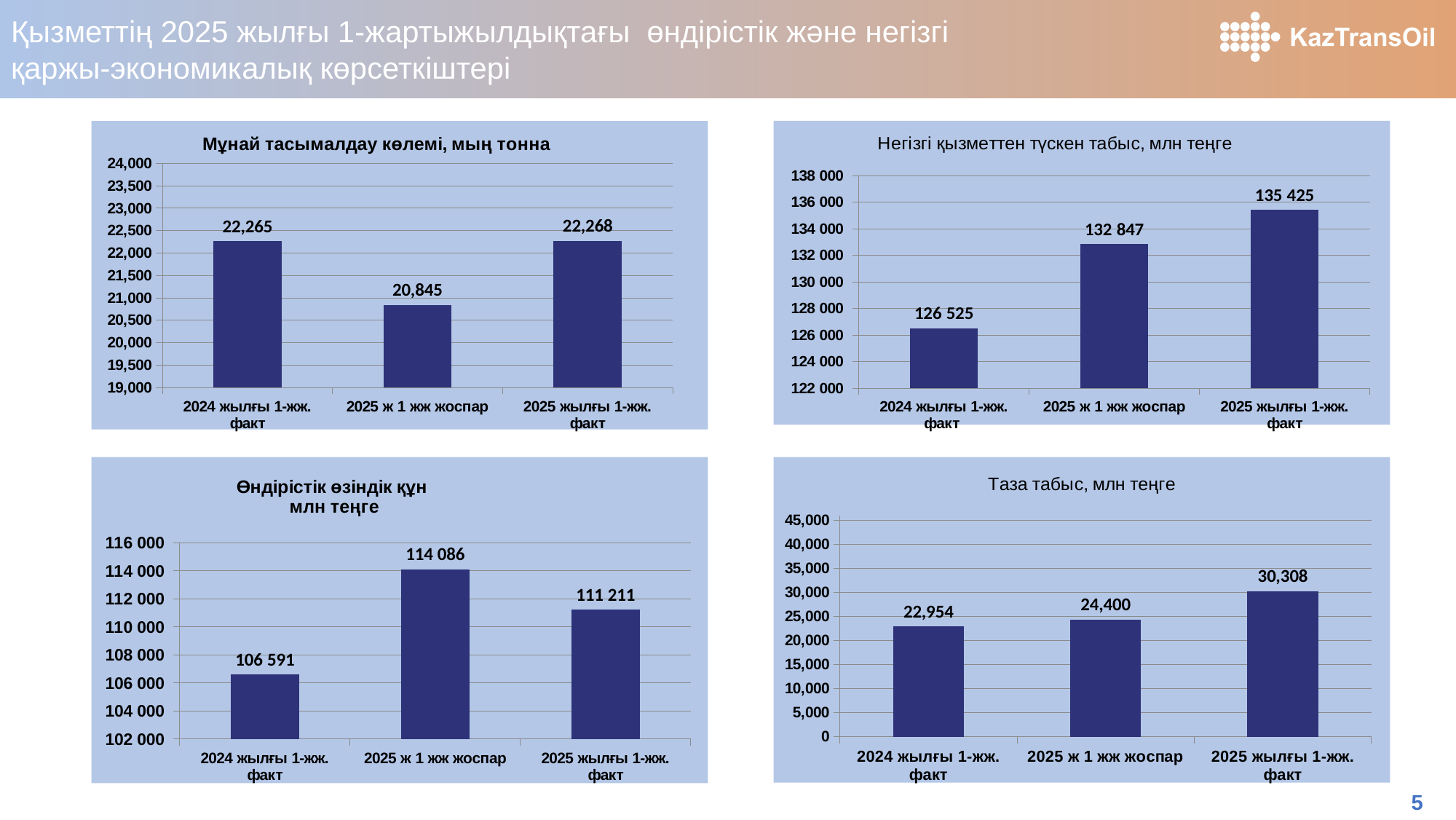
In the chart 'Таза табыс, млн теңге', what is the value for '2025 жылғы 1-жж. факт'? 30,308 In the chart 'Негізгі қызметтен түскен табыс, млн теңге', what is the difference between '2025 жылғы 1-жж. факт' and '2024 жылғы 1-жж. факт'? 8 900 In the chart 'Негізгі қызметтен түскен табыс, млн теңге', do the values rise or fall from left to right? rise In the chart 'Таза табыс, млн теңге', which is larger: '2025 ж 1 жж жоспар' or '2024 жылғы 1-жж. факт'? 2025 ж 1 жж жоспар In the chart 'Таза табыс, млн теңге', how many bars are plotted? 3 In the chart 'Өндірістік өзіндік құн млн теңге', what is the difference between '2025 ж 1 жж жоспар' and '2025 жылғы 1-жж. факт'? 2 875 In the chart 'Мұнай тасымалдау көлемі, мың тонна', what is the value for '2025 ж 1 жж жоспар'? 20,845 In the chart 'Мұнай тасымалдау көлемі, мың тонна', which category has the lowest value? 2025 ж 1 жж жоспар In the chart 'Өндірістік өзіндік құн млн теңге', what is the value for '2024 жылғы 1-жж. факт'? 106 591 What kind of chart is 'Таза табыс, млн теңге'? bar chart In the chart 'Негізгі қызметтен түскен табыс, млн теңге', what is the value for '2025 жылғы 1-жж. факт'? 135 425 In the chart 'Өндірістік өзіндік құн млн теңге', which category has the highest value? 2025 ж 1 жж жоспар